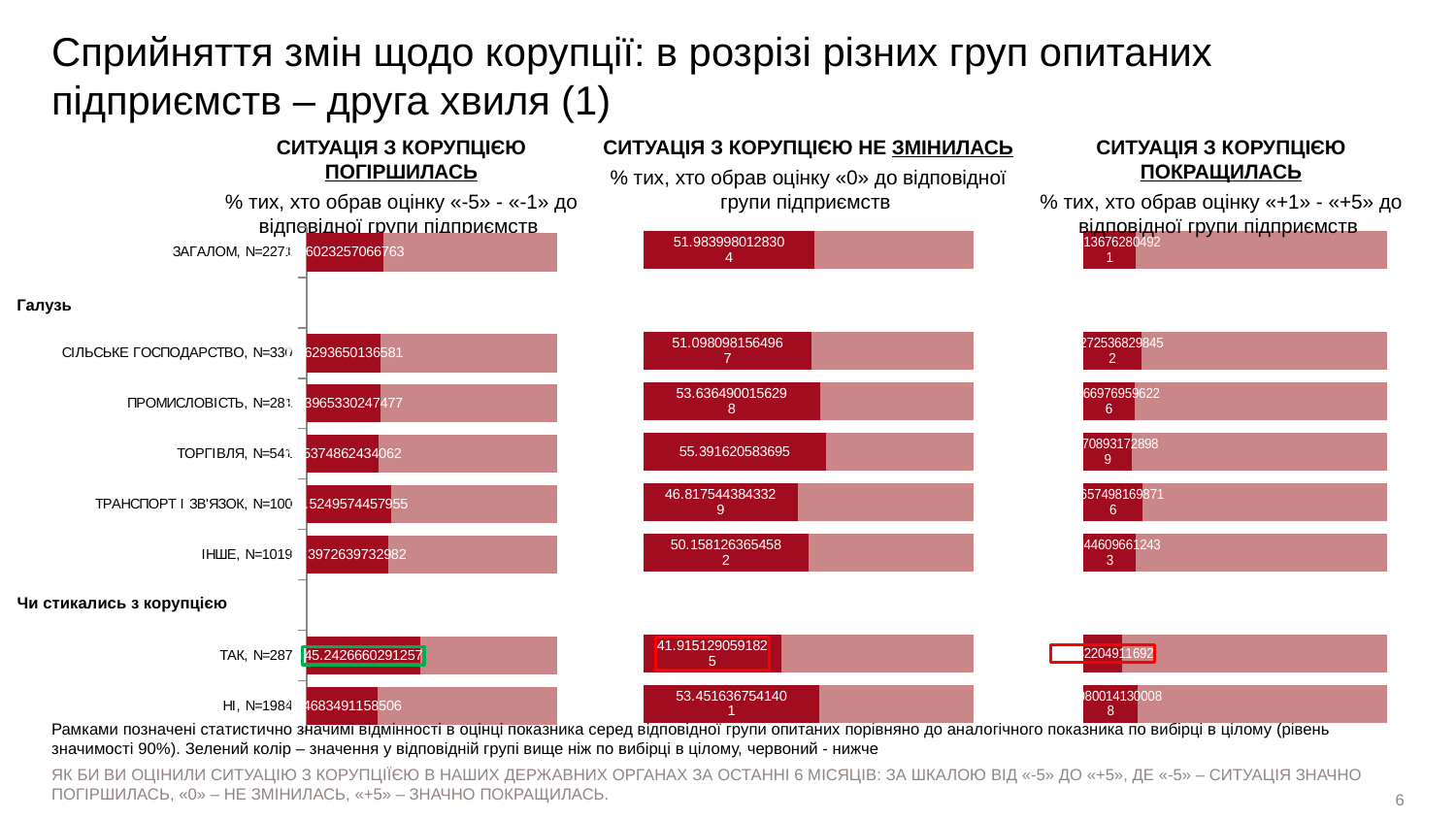
In the chart "СИТУАЦІЯ З КОРУПЦІЄЮ НЕ ЗМІНИЛАСЬ", which category has the highest value? ТОРГІВЛЯ, N=541 In the chart "СИТУАЦІЯ З КОРУПЦІЄЮ НЕ ЗМІНИЛАСЬ", what is the value for ТОРГІВЛЯ, N=541? 55.391620583695 In the chart "СИТУАЦІЯ З КОРУПЦІЄЮ НЕ ЗМІНИЛАСЬ", what is the value for ЗАГАЛОМ, N=2271? 51.9839980128304 In the chart "СИТУАЦІЯ З КОРУПЦІЄЮ ПОГІРШИЛАСЬ", what is the value for ТАК, N=287? 45.2426660291257 In the chart "СИТУАЦІЯ З КОРУПЦІЄЮ НЕ ЗМІНИЛАСЬ", what is the value for ТАК, N=287? 41.9151290591825 In the chart "СИТУАЦІЯ З КОРУПЦІЄЮ НЕ ЗМІНИЛАСЬ", which is larger: the value for ТОРГІВЛЯ, N=541 or for ТРАНСПОРТ І ЗВ'ЯЗОК, N=100? ТОРГІВЛЯ, N=541 What is the title of the rightmost chart on the slide? СИТУАЦІЯ З КОРУПЦІЄЮ ПОКРАЩИЛАСЬ In the chart "СИТУАЦІЯ З КОРУПЦІЄЮ НЕ ЗМІНИЛАСЬ", which category has the lowest value? ТАК, N=287 In the chart "СИТУАЦІЯ З КОРУПЦІЄЮ НЕ ЗМІНИЛАСЬ", how many categories (bars) are plotted? 8 In the chart "СИТУАЦІЯ З КОРУПЦІЄЮ НЕ ЗМІНИЛАСЬ", what is the difference between the values for ПРОМИСЛОВІСТЬ, N=281 and СІЛЬСЬКЕ ГОСПОДАРСТВО, N=330? 2.5383918591331 How many charts are shown on the slide? 3 What kind of chart is used for "СИТУАЦІЯ З КОРУПЦІЄЮ НЕ ЗМІНИЛАСЬ"? Bar chart